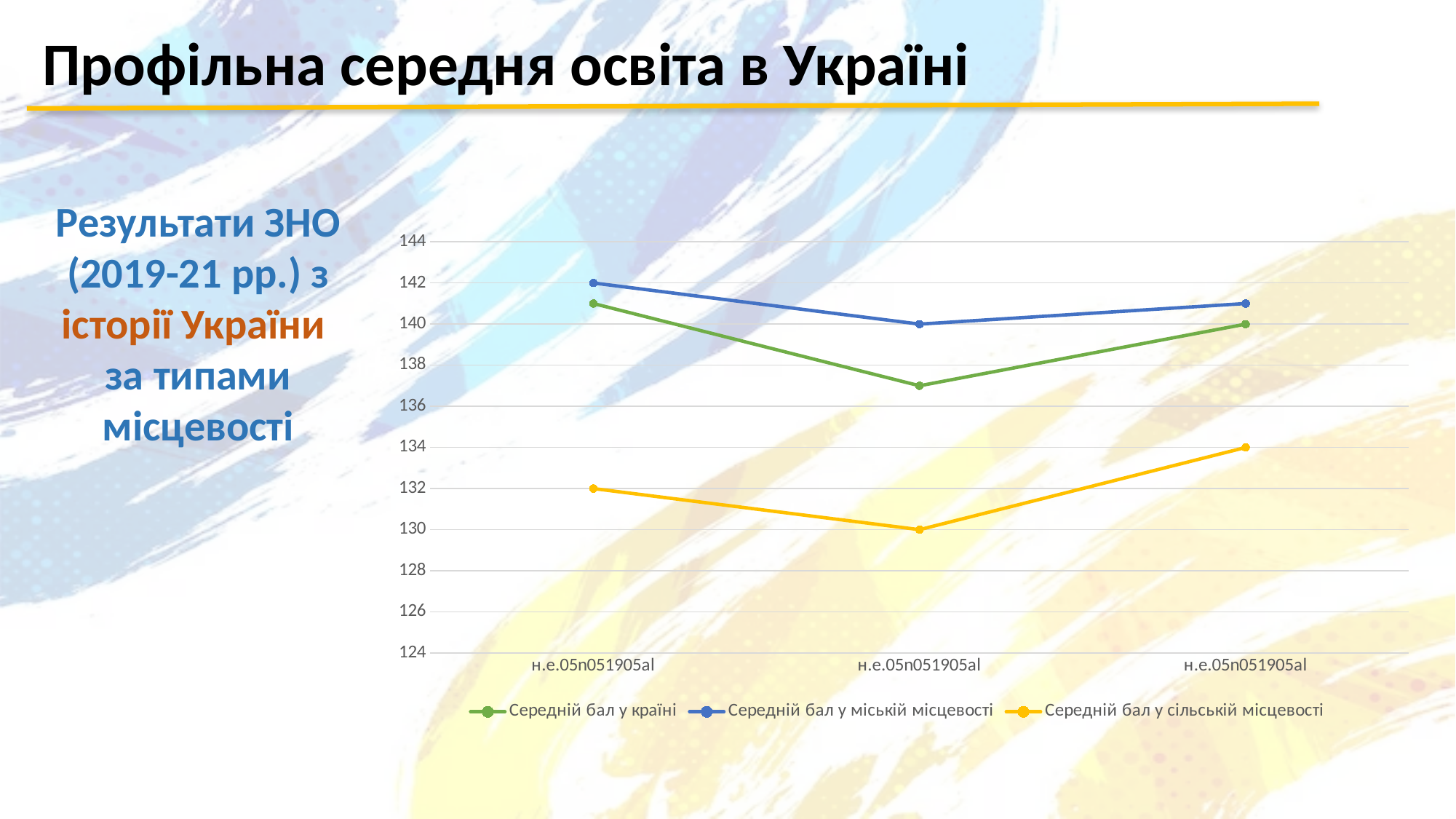
How many series does the legend list? 3 Is the value of the second point of the series "Середній бал у країні" greater or less than 138? less What is the value of the third point of the series "Середній бал у країні"? 140 What is the value of the first point of the series "Середній бал у міській місцевості"? 142 Which series has the lowest values across all points? Середній бал у сільській місцевості How many data points does each series have along the x axis? 3 Does the series "Середній бал у сільській місцевості" rise or fall from the second point to the third point? rise Which series has the highest value at the first point? Середній бал у міській місцевості What is the value of the third point of the series "Середній бал у сільській місцевості"? 134 What kind of chart is shown on the slide? line chart What is the value of the second point of the series "Середній бал у сільській місцевості"? 130 What is the difference between the third and second points of the series "Середній бал у сільській місцевості"? 4